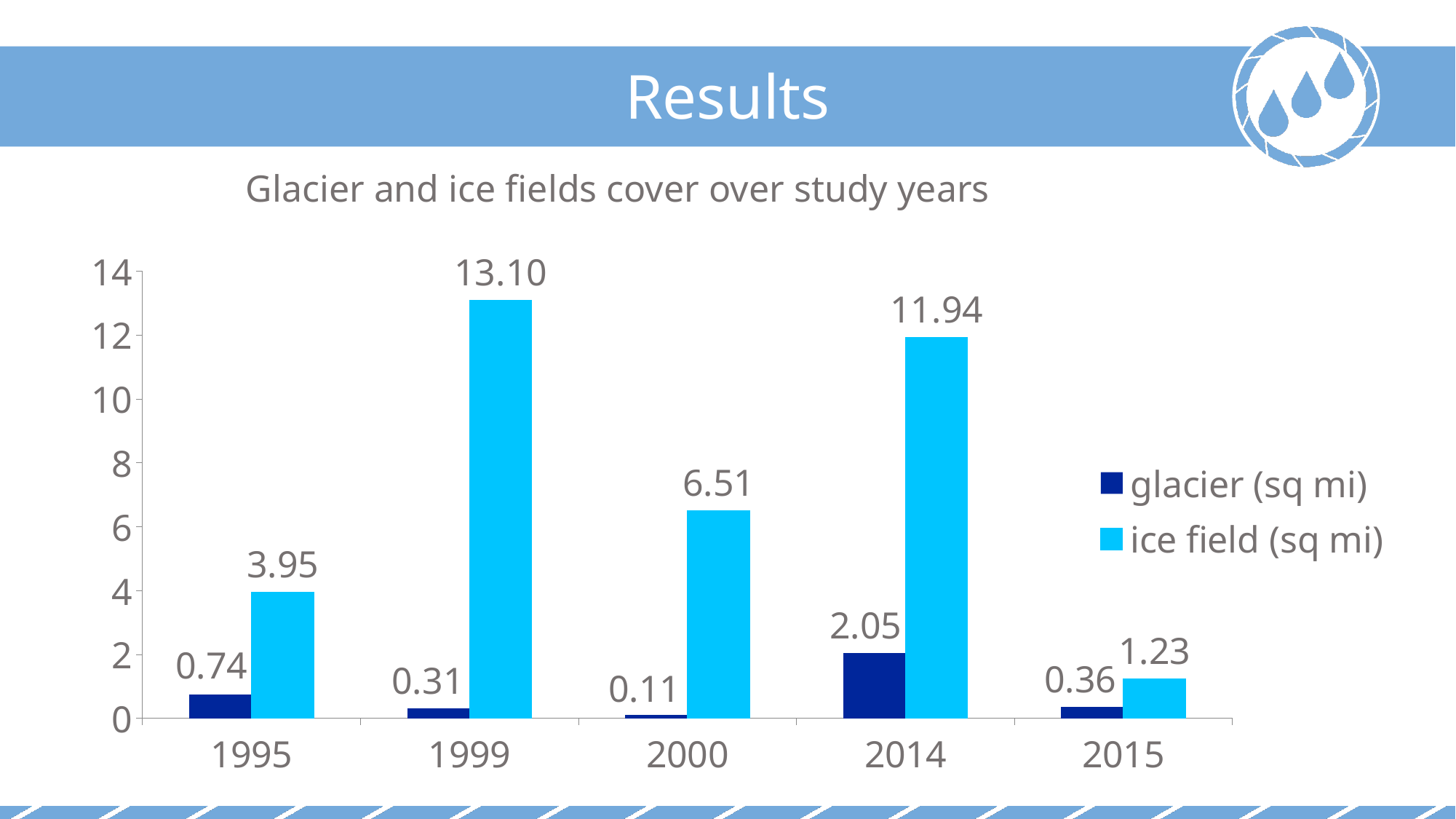
What is the glacier (sq mi) value for 2014? 2.05 Is the ice field (sq mi) value for 2000 greater or less than 6? greater Which year has the lowest glacier (sq mi) value? 2000 Which is larger, the glacier (sq mi) value for 1995 or for 2015? 1995 What is the glacier (sq mi) value for 2000? 0.11 What is the difference between the ice field (sq mi) values for 1999 and 2014? 1.16 What is the title of the chart? Glacier and ice fields cover over study years What kind of chart is shown on the slide? bar chart How many years are shown on the x axis? 5 Which year has the highest ice field (sq mi) value? 1999 What is the ice field (sq mi) value for 1999? 13.10 How many series does the legend list? 2